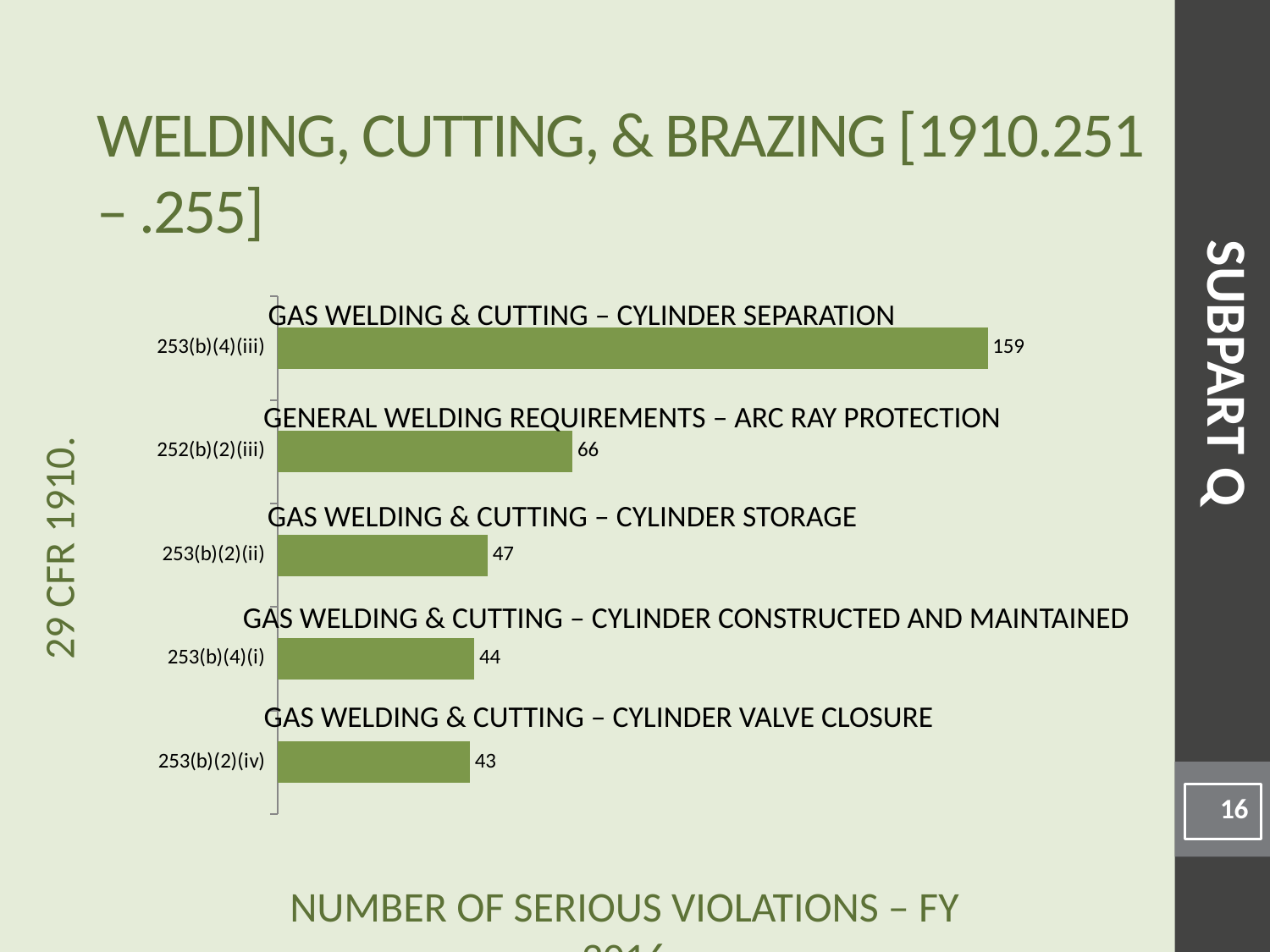
Which standard is described as 'GAS WELDING & CUTTING – CYLINDER STORAGE'? 253(b)(2)(ii) What is the number of serious violations for 253(b)(2)(ii)? 47 What is the number of serious violations for 253(b)(4)(i)? 44 Which category has the highest number of serious violations? 253(b)(4)(iii) What is the number of serious violations for 252(b)(2)(iii)? 66 Which has more serious violations, 253(b)(2)(ii) or 253(b)(4)(i)? 253(b)(2)(ii) What is the difference between the values for 253(b)(4)(iii) and 252(b)(2)(iii)? 93 What is the number of serious violations for 253(b)(2)(iv)? 43 Which category has the lowest number of serious violations? 253(b)(2)(iv) How many categories are shown in the chart? 5 What is the number of serious violations for 253(b)(4)(iii)? 159 What kind of chart is shown on the slide? Bar chart